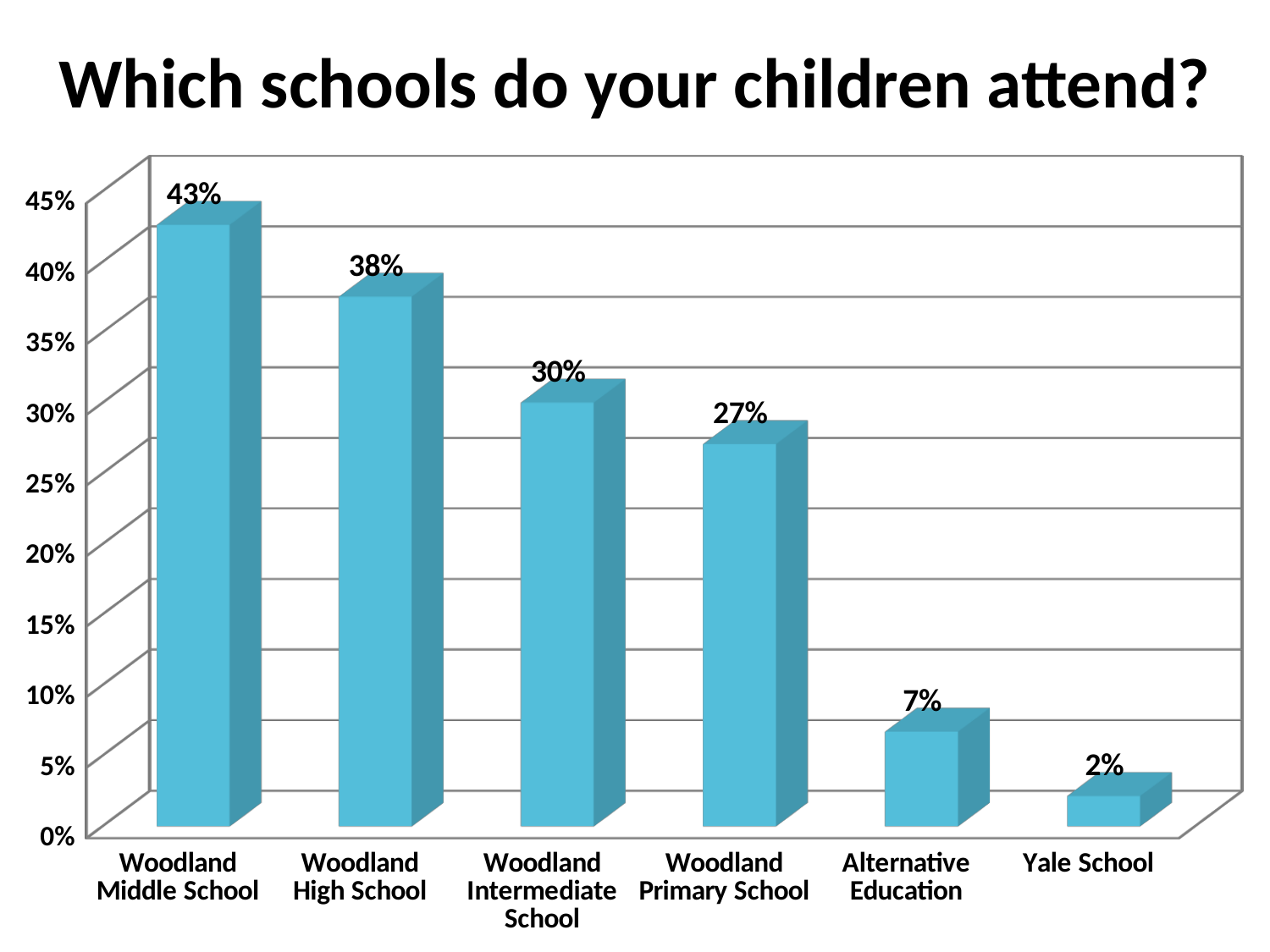
What is the title of the chart? Which schools do your children attend? What is the difference between the values for Woodland Middle School and Woodland High School? 5% What is the difference between the values for Woodland Primary School and Alternative Education? 20% What is the value shown for Yale School? 2% Is the value for Alternative Education greater or less than 10%? less How many categories are shown on the chart? 6 Which category has the lowest percentage? Yale School Which is larger, the value for Woodland High School or the value for Woodland Primary School? Woodland High School What percentage of respondents' children attend Woodland Middle School? 43% Which school has the highest percentage? Woodland Middle School What is the value shown for Woodland Intermediate School? 30% What kind of chart is shown on the slide? bar chart